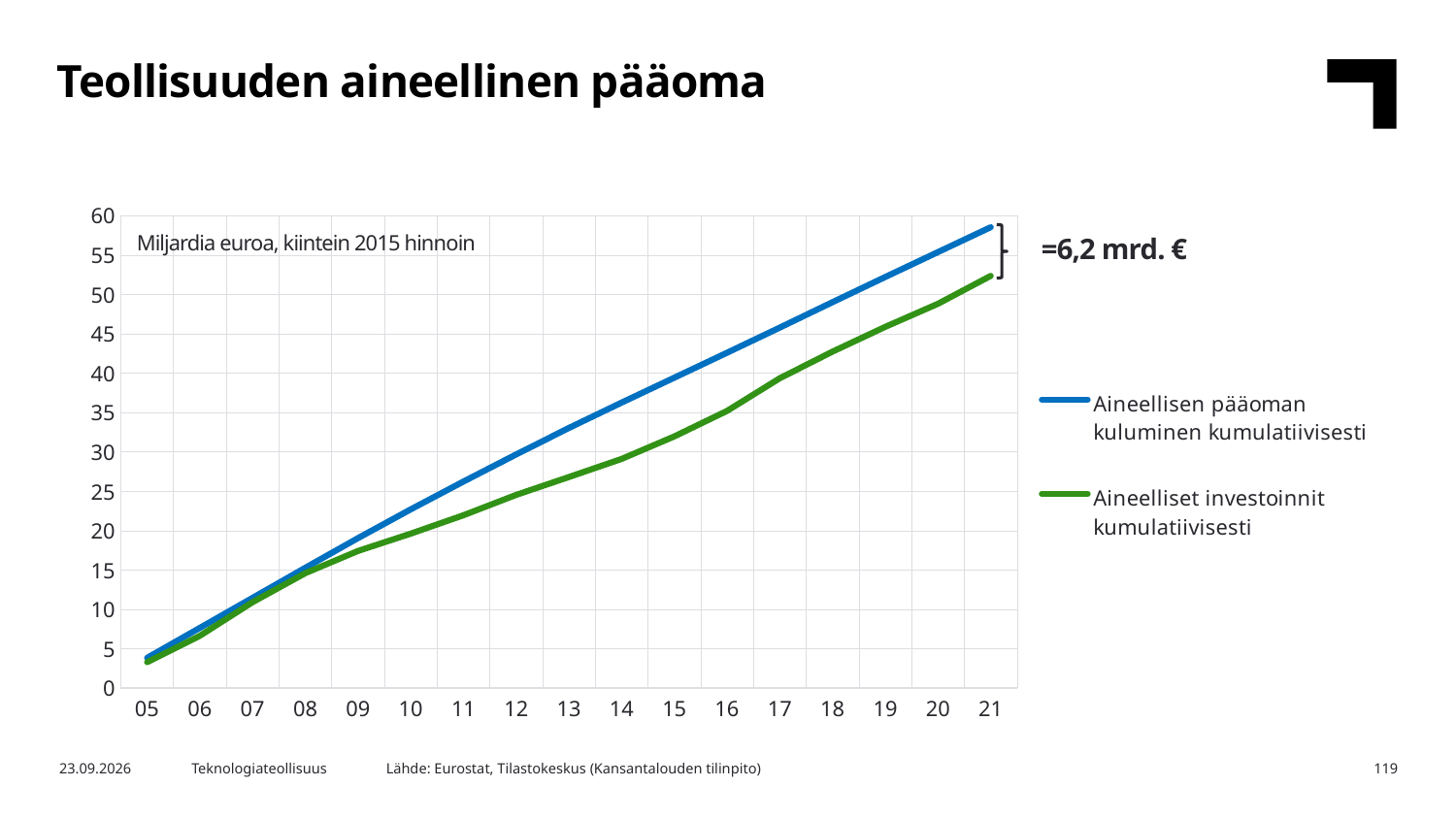
How many years are shown on the x axis? 17 Is the value for 'Aineelliset investoinnit kumulatiivisesti' in 21 greater or less than 50? greater In 21, which series has the higher value: 'Aineellisen pääoman kuluminen kumulatiivisesti' or 'Aineelliset investoinnit kumulatiivisesti'? Aineellisen pääoman kuluminen kumulatiivisesti According to the annotation on the chart, what is the gap between the two lines in 21? 6,2 mrd. € Do the values of 'Aineelliset investoinnit kumulatiivisesti' rise or fall from 05 to 21? rise Is the value for 'Aineellisen pääoman kuluminen kumulatiivisesti' in 05 greater or less than 5? less What is the title of the chart? Teollisuuden aineellinen pääoma How many series does the legend list? 2 Do the values of 'Aineellisen pääoman kuluminen kumulatiivisesti' rise or fall from 05 to 21? rise What kind of chart is shown on the slide? line chart Is the value for 'Aineellisen pääoman kuluminen kumulatiivisesti' in 21 greater or less than 55? greater